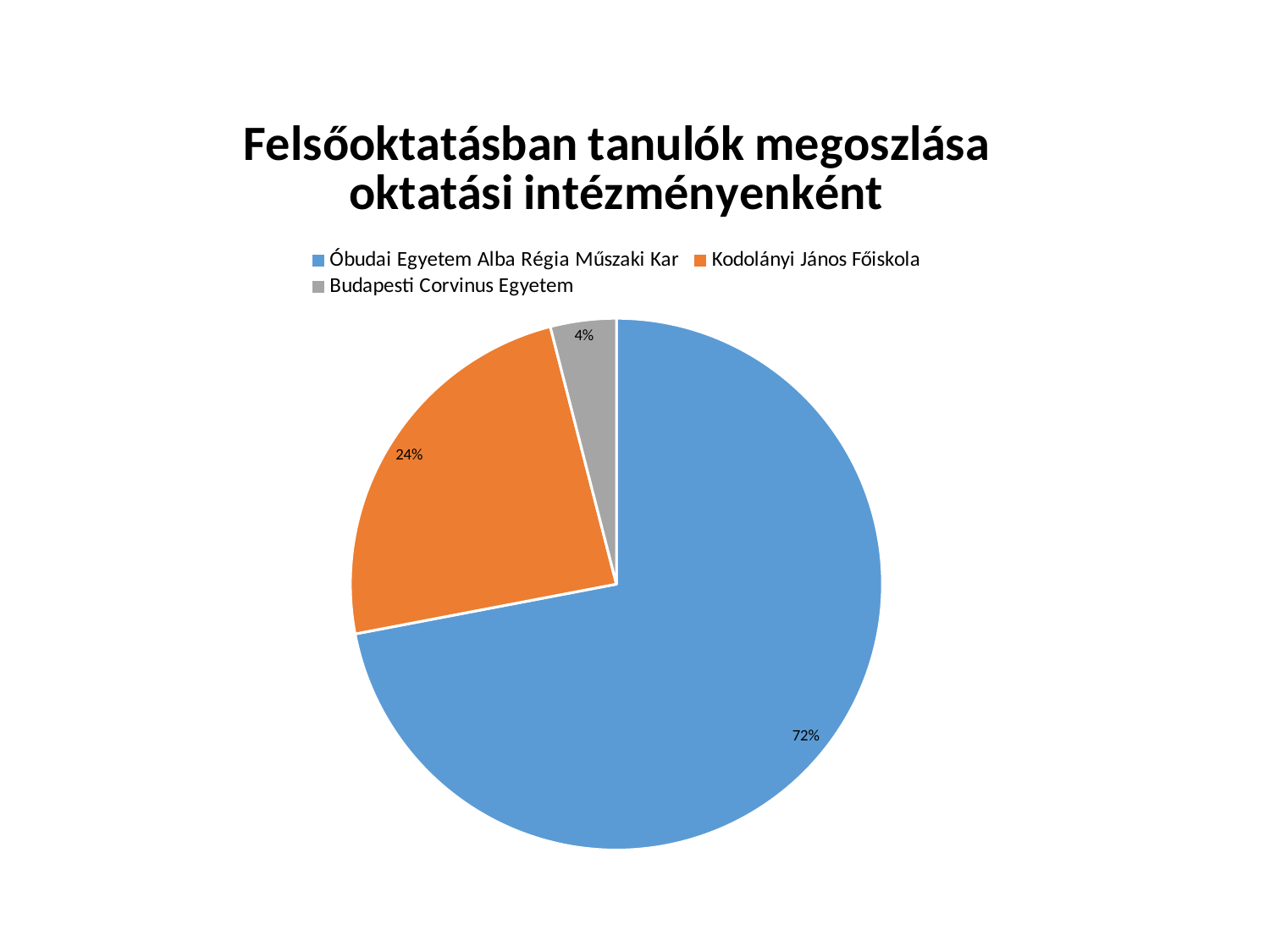
What share of the pie does Óbudai Egyetem Alba Régia Műszaki Kar have? 72% What share of the pie does Kodolányi János Főiskola have? 24% Which colour represents Kodolányi János Főiskola in the pie chart? orange Which institution has the largest share of the pie? Óbudai Egyetem Alba Régia Műszaki Kar What is the title of the chart? Felsőoktatásban tanulók megoszlása oktatási intézményenként What share of the pie does Budapesti Corvinus Egyetem have? 4% Which has a larger share, Kodolányi János Főiskola or Budapesti Corvinus Egyetem? Kodolányi János Főiskola What kind of chart is shown on the slide? pie chart What is the difference in percentage points between the shares of Óbudai Egyetem Alba Régia Műszaki Kar and Kodolányi János Főiskola? 48 percentage points How many slices does the pie chart have? 3 Which institution has the smallest share of the pie? Budapesti Corvinus Egyetem What is the difference in percentage points between the shares of Kodolányi János Főiskola and Budapesti Corvinus Egyetem? 20 percentage points